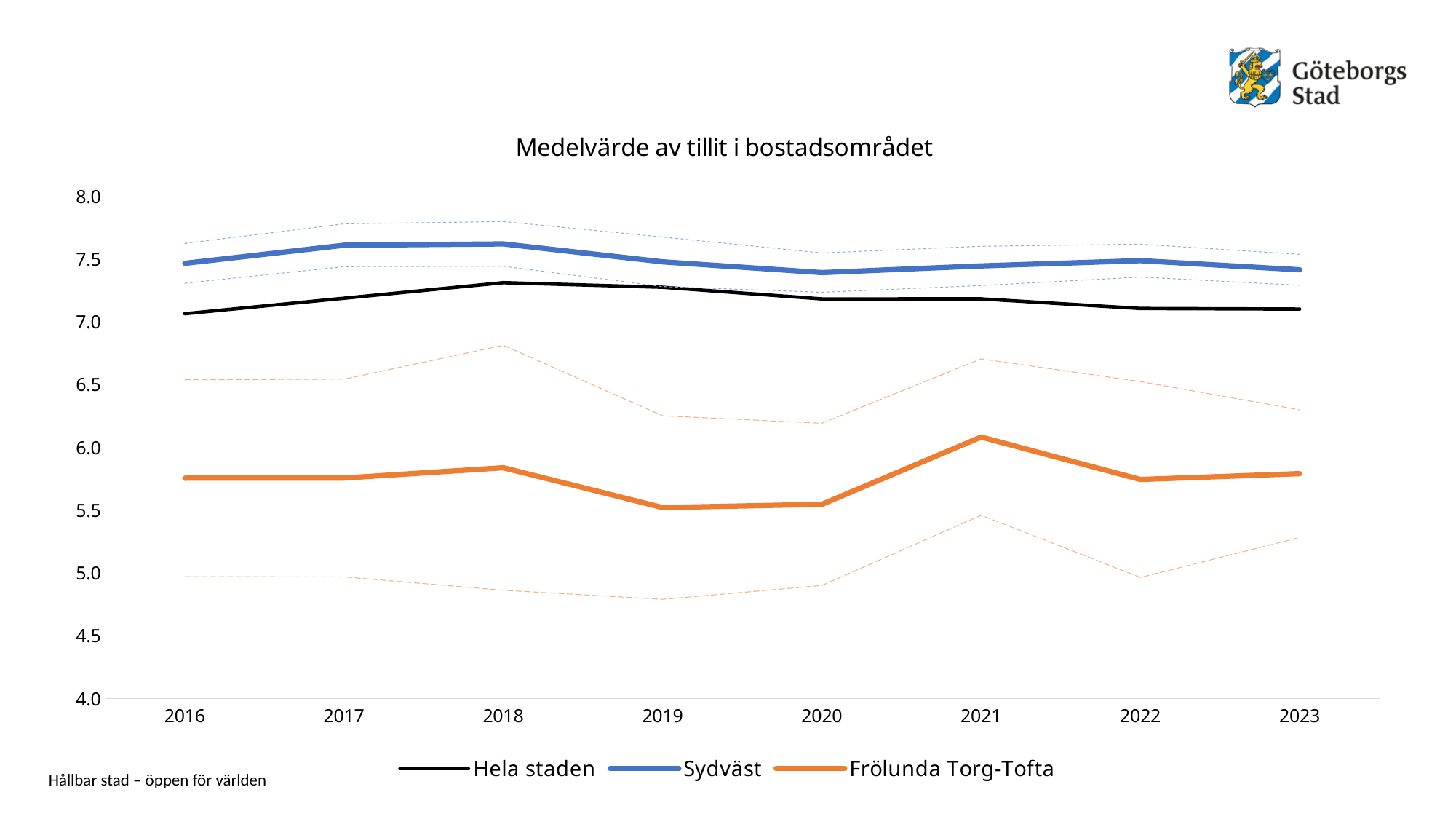
What kind of chart is shown on the slide? line chart Which series is drawn in orange? Frölunda Torg-Tofta Is the value for Sydväst in 2020 greater or less than 7.5? less In which year is the value for Frölunda Torg-Tofta highest? 2021 Which series has the higher value in 2023, Hela staden or Sydväst? Sydväst Which series has the lower value in 2016, Hela staden or Frölunda Torg-Tofta? Frölunda Torg-Tofta Is the value for Sydväst in 2018 greater or less than 7.5? greater How many years are shown on the x axis? 8 What is the title of the chart? Medelvärde av tillit i bostadsområdet How many series does the legend list? 3 Does the value for Sydväst rise or fall from 2018 to 2020? fall Is the value for Frölunda Torg-Tofta in 2021 greater or less than 6.0? greater